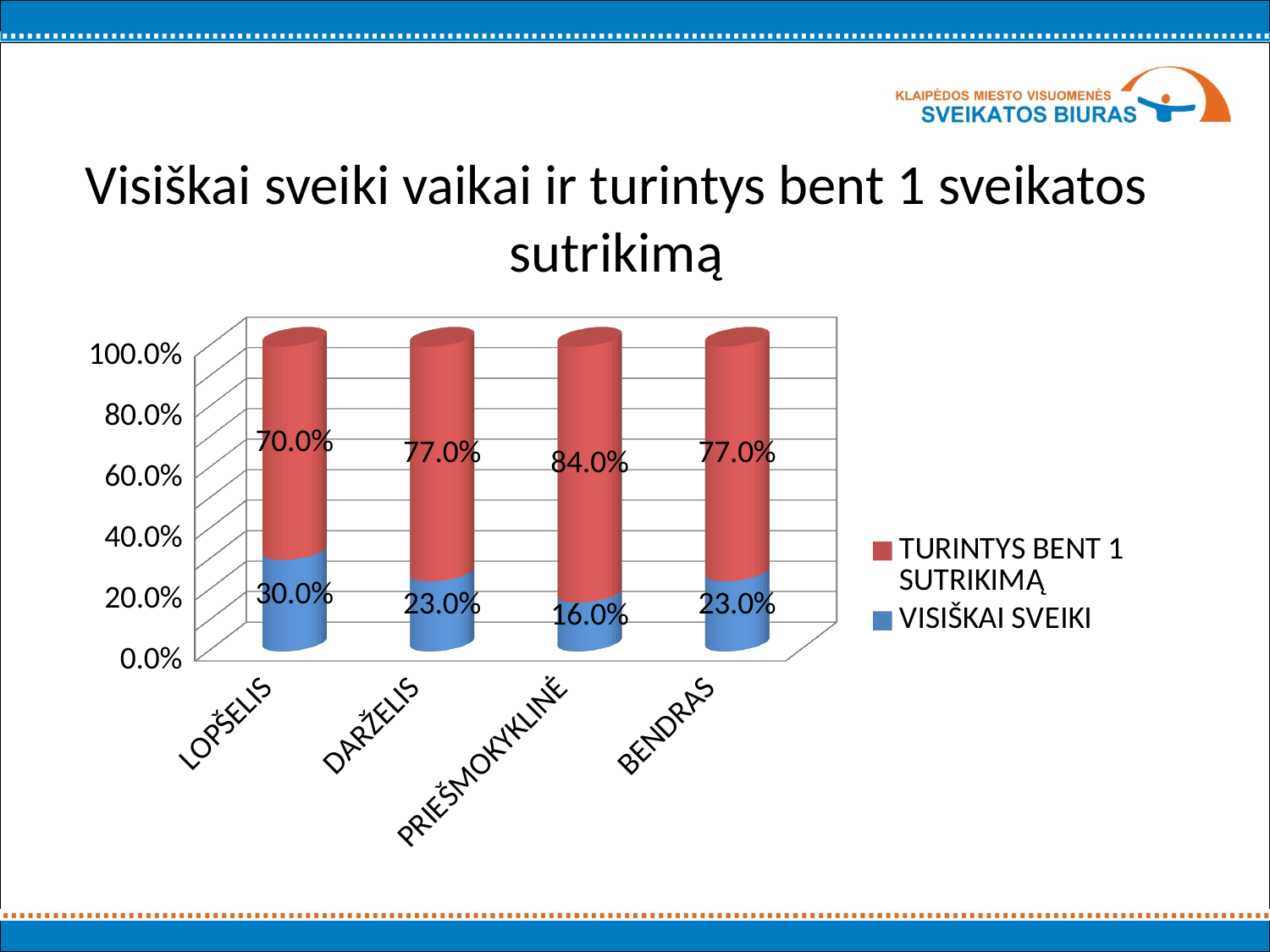
What kind of chart is shown on the slide? Stacked bar chart Which category has the highest value for VISIŠKAI SVEIKI? LOPŠELIS What is the difference between the TURINTYS BENT 1 SUTRIKIMĄ values for PRIEŠMOKYKLINĖ and LOPŠELIS? 14.0% Which is larger: the VISIŠKAI SVEIKI value for DARŽELIS or for PRIEŠMOKYKLINĖ? DARŽELIS What is the value for VISIŠKAI SVEIKI in the LOPŠELIS category? 30.0% What is the total of the stacked bar for DARŽELIS? 100.0% How many series does the legend list? 2 Which category has the lowest value for VISIŠKAI SVEIKI? PRIEŠMOKYKLINĖ What is the value for TURINTYS BENT 1 SUTRIKIMĄ in the PRIEŠMOKYKLINĖ category? 84.0% How many categories are shown on the x axis? 4 What is the value for VISIŠKAI SVEIKI in the BENDRAS category? 23.0% Which category has the highest value for TURINTYS BENT 1 SUTRIKIMĄ? PRIEŠMOKYKLINĖ